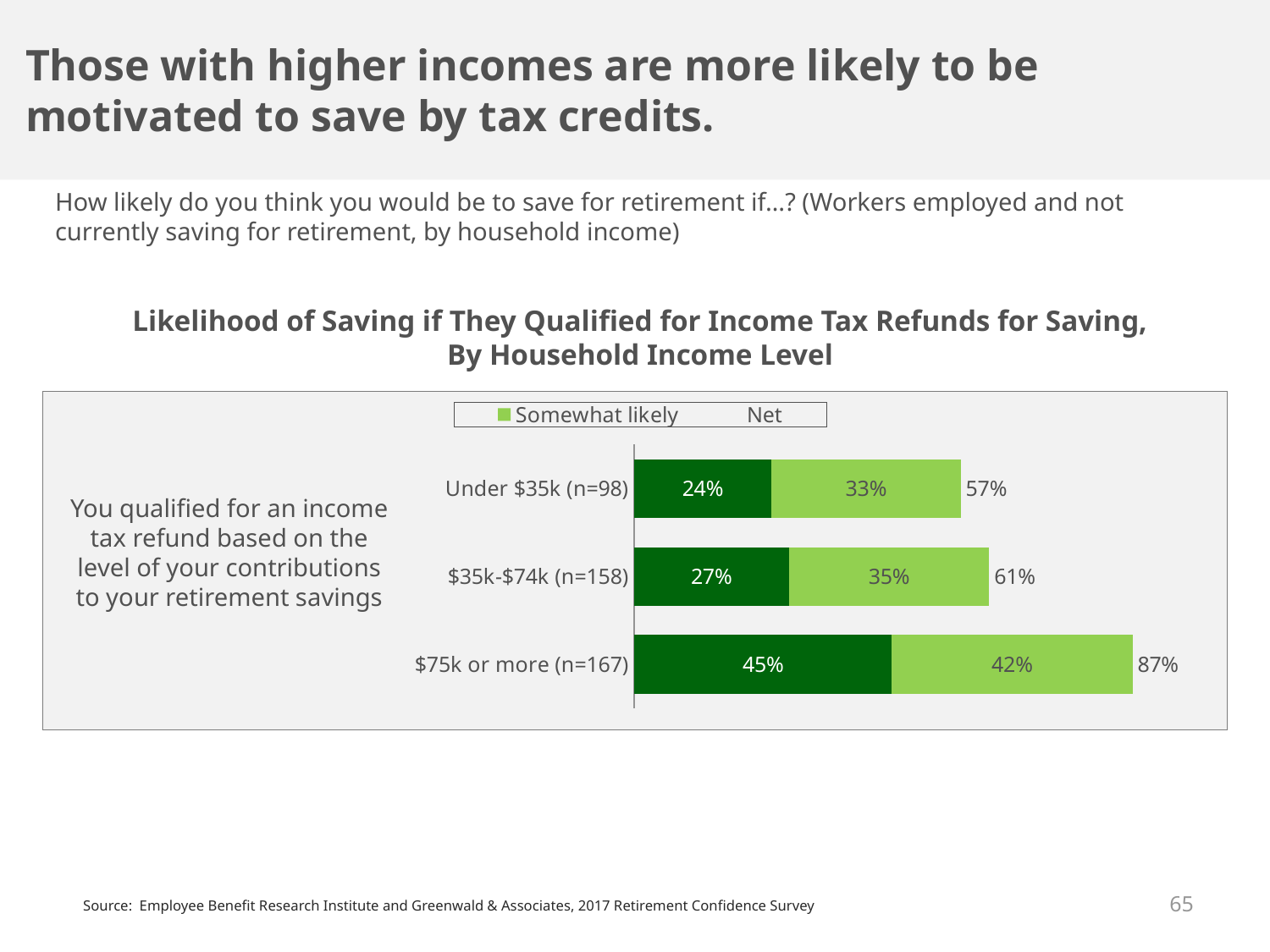
Which household income level has the lowest Somewhat likely value? Under $35k (n=98) Do the Net values rise or fall as household income increases from Under $35k to $75k or more? Rise What is the Somewhat likely value for Under $35k (n=98)? 33% How many household income levels are shown in the chart? 3 What is the value of the dark green segment for $35k-$74k (n=158)? 27% Which household income level has the highest Net value? $75k or more (n=167) What is the difference between the Net value for $75k or more (n=167) and the Net value for Under $35k (n=98)? 30 percentage points What is the total of the two stacked segments for Under $35k (n=98)? 57% What is the Net value for $75k or more (n=167)? 87% What kind of chart is shown on the slide? Stacked bar chart What is the title of the chart? Likelihood of Saving if They Qualified for Income Tax Refunds for Saving, By Household Income Level Which is larger: the Somewhat likely value for $35k-$74k (n=158) or for $75k or more (n=167)? $75k or more (n=167)